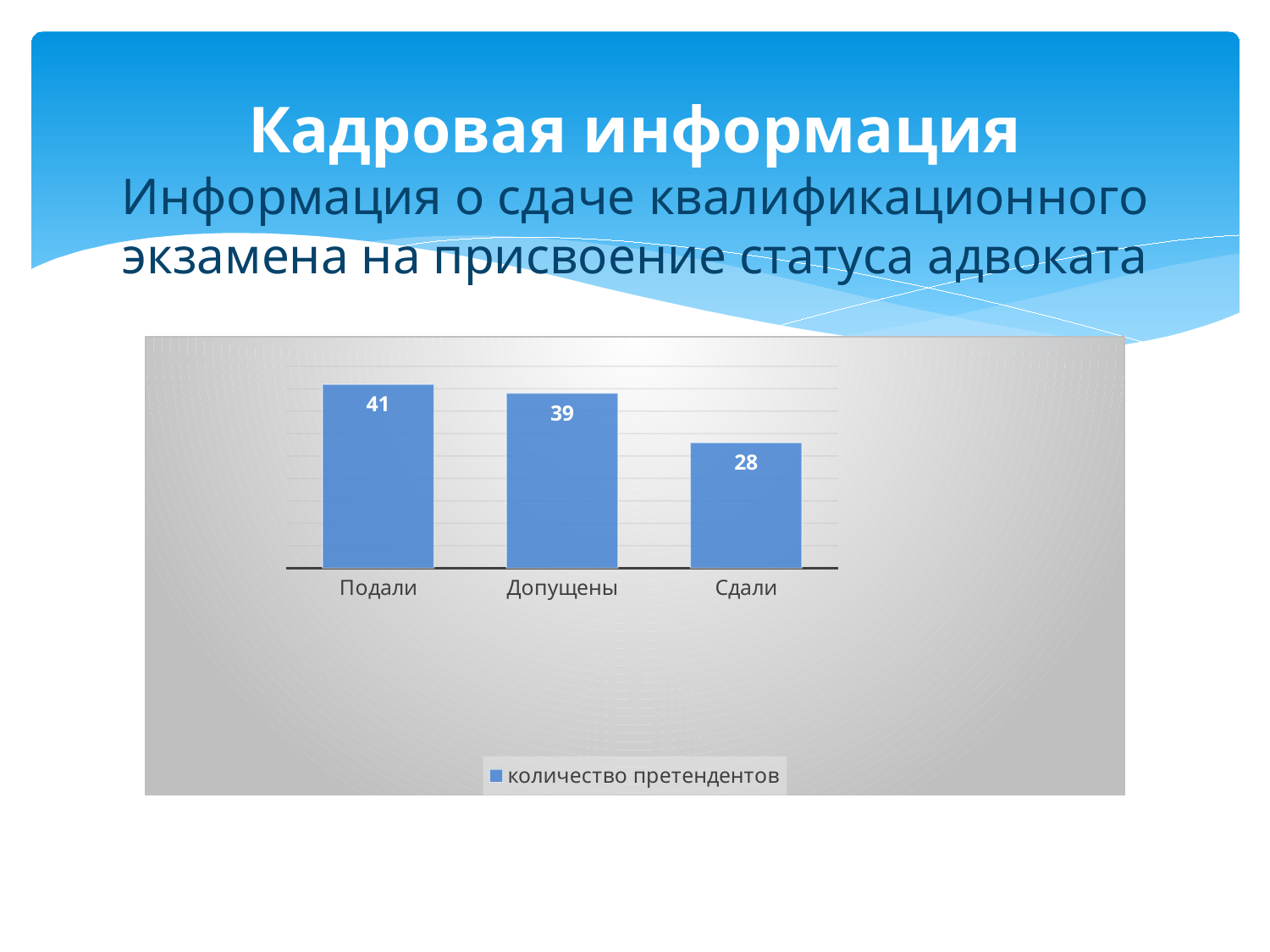
What is the name of the series shown in the legend? количество претендентов What is the difference between the values for Подали and Сдали? 13 What is the value for Подали? 41 How many categories are shown on the x axis? 3 Which category has the lowest value? Сдали How many series does the legend list? 1 Which category has the highest value? Подали What is the value for Сдали? 28 What is the difference between the values for Допущены and Сдали? 11 Which is larger, the value for Допущены or the value for Сдали? Допущены What is the value for Допущены? 39 What kind of chart is shown on the slide? bar chart